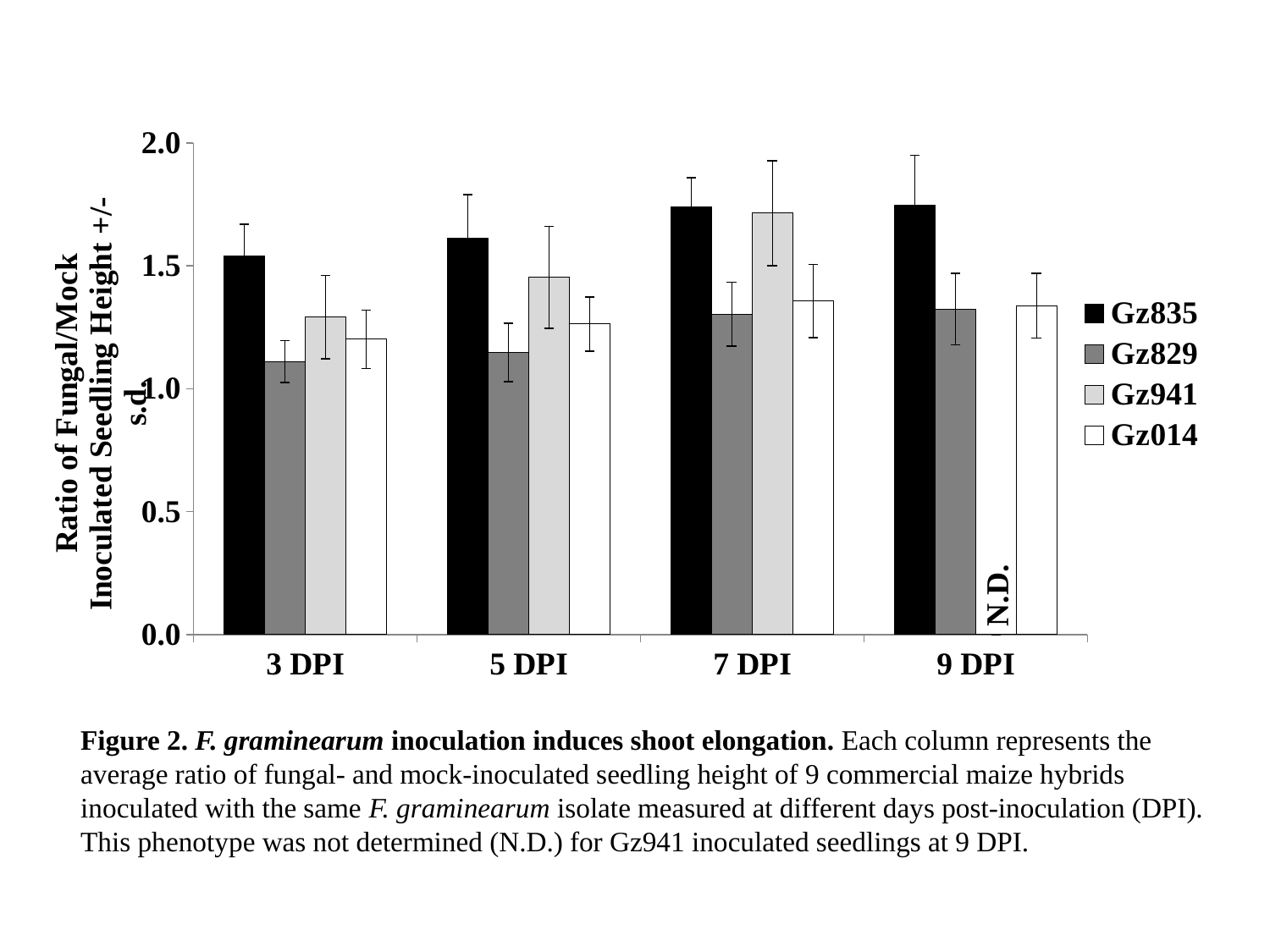
Is the value for Gz941 at 7 DPI greater or less than 1.5? greater At 5 DPI, which is larger, the value for Gz835 or the value for Gz829? Gz835 Is the value for Gz829 at 3 DPI greater or less than 1.5? less Is the value for Gz835 at 7 DPI greater or less than 1.5? greater Which series is marked N.D. at 9 DPI? Gz941 What kind of chart is shown on the slide? bar chart Which series has the lowest value at 5 DPI? Gz829 How many DPI categories are shown on the x axis? 4 Does the value for Gz835 rise or fall from 3 DPI to 9 DPI? rise How many series does the legend list? 4 Which series has the highest value at 3 DPI? Gz835